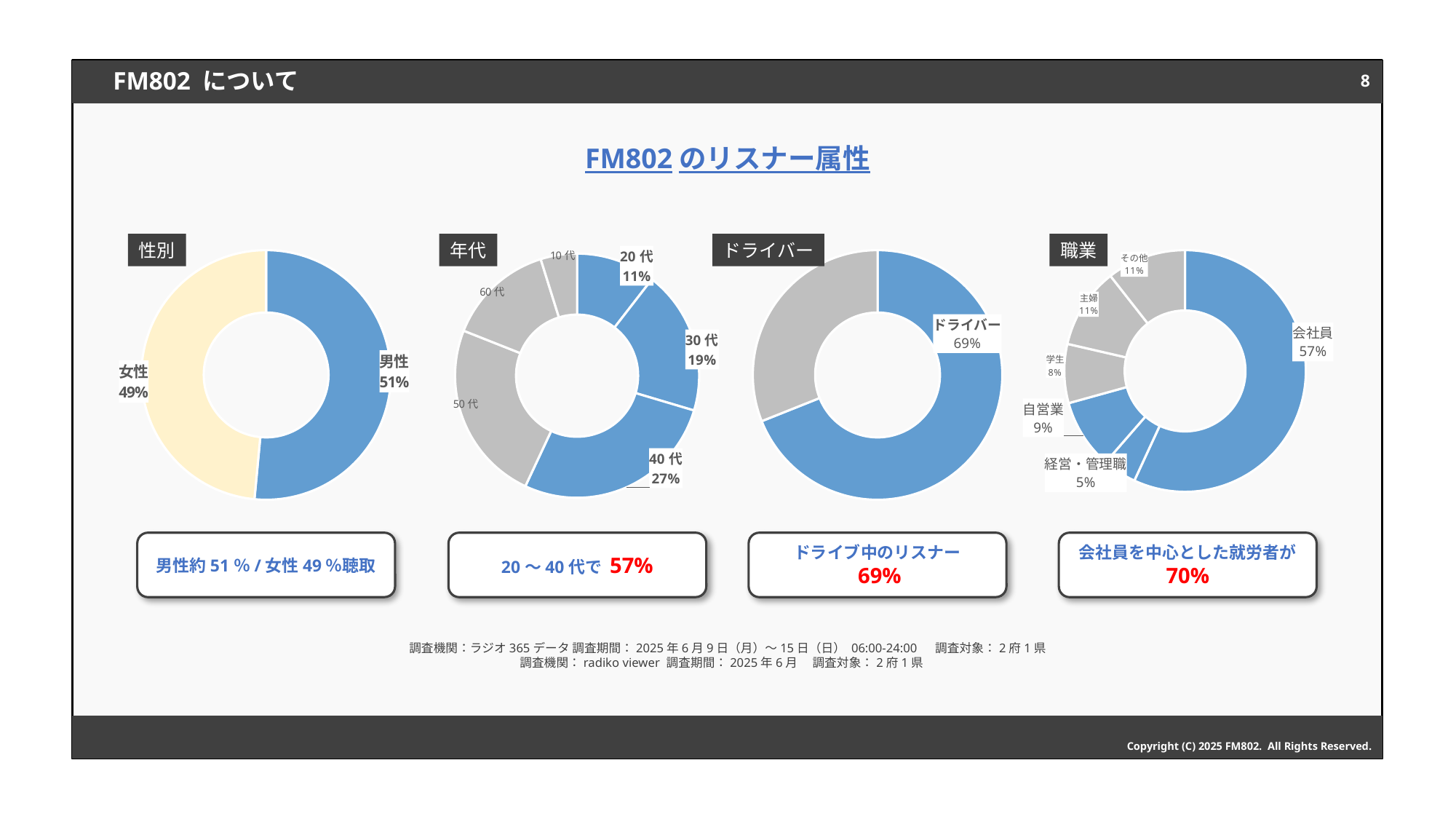
In the 性別 chart, what percentage is shown for 女性? 49% In the 職業 chart, which is larger, 自営業 or 主婦? 主婦 In the 年代 chart, how many age categories are shown? 6 In the 性別 chart, what percentage is shown for 男性? 51% In the ドライバー chart, what percentage is shown for ドライバー? 69% In the 年代 chart, what percentage is shown for 20 代? 11% In the 職業 chart, which category has the smallest share? 経営・管理職 In the 職業 chart, what percentage is shown for 学生? 8% In the 職業 chart, which category has the largest share? 会社員 What type of chart is used for the 性別 data? Donut (pie) chart In the 年代 chart, what is the difference between the 40 代 and 30 代 percentages? 8% In the 年代 chart, what percentage is shown for 40 代? 27%